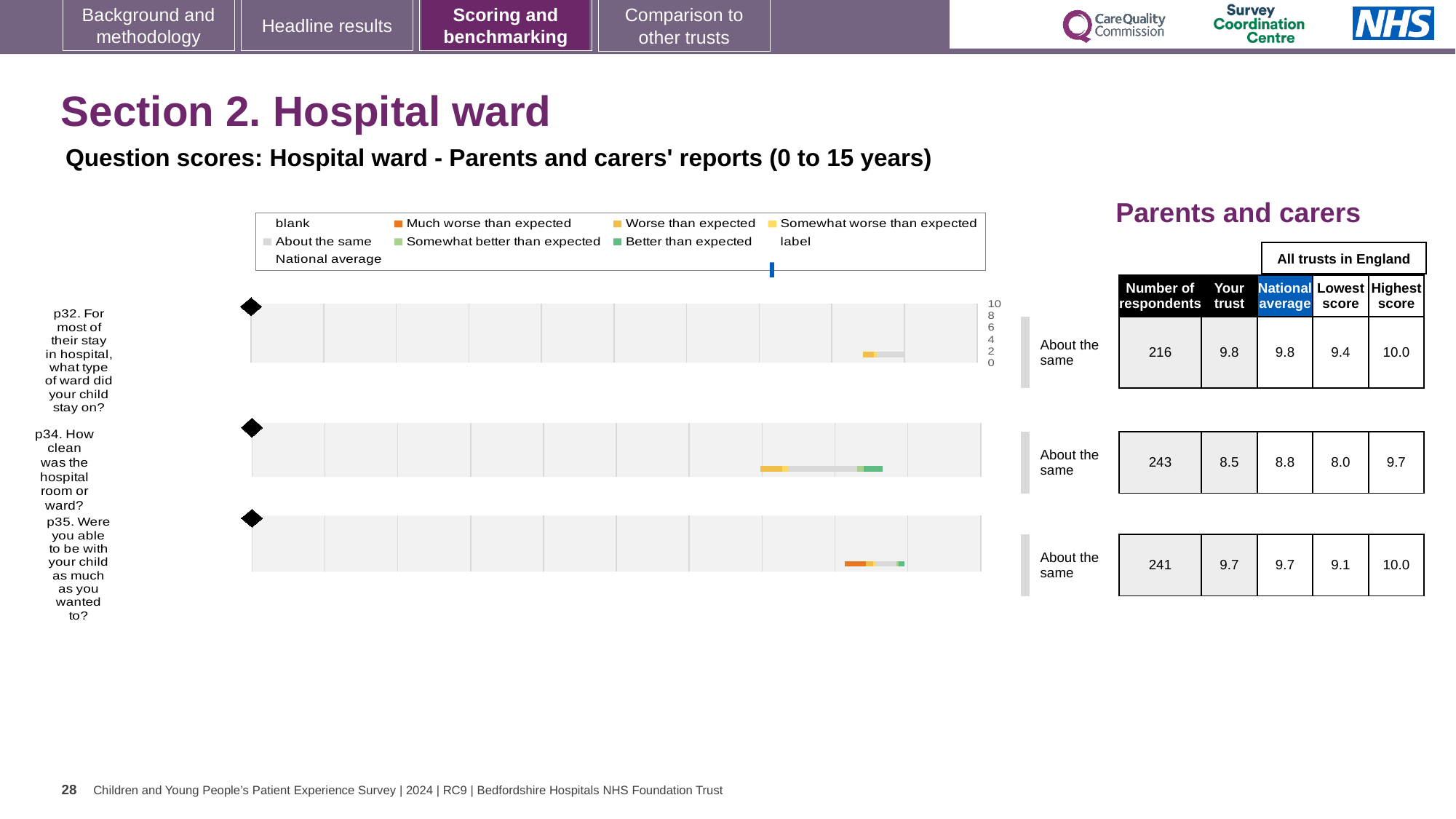
Which is larger, the 'Your trust' score for p32 or for p34? p32 What benchmark category is shown for p35? About the same What is the national average score for p32 (For most of their stay in hospital, what type of ward did your child stay on?)? 9.8 How many entries does the chart legend list? 9 What kind of chart is used to show the question scores on this slide? bar chart What is the 'Your trust' score for p34 (How clean was the hospital room or ward?)? 8.5 What is the difference between the highest score and the lowest score for p34? 1.7 Which question has the highest number of respondents? p34 How many questions (p32, p34, p35) are plotted as bars on the slide? 3 What is the highest score across all trusts in England for p34? 9.7 How many respondents answered p35 (Were you able to be with your child as much as you wanted to?)? 241 Which question has the lowest 'Your trust' score? p34